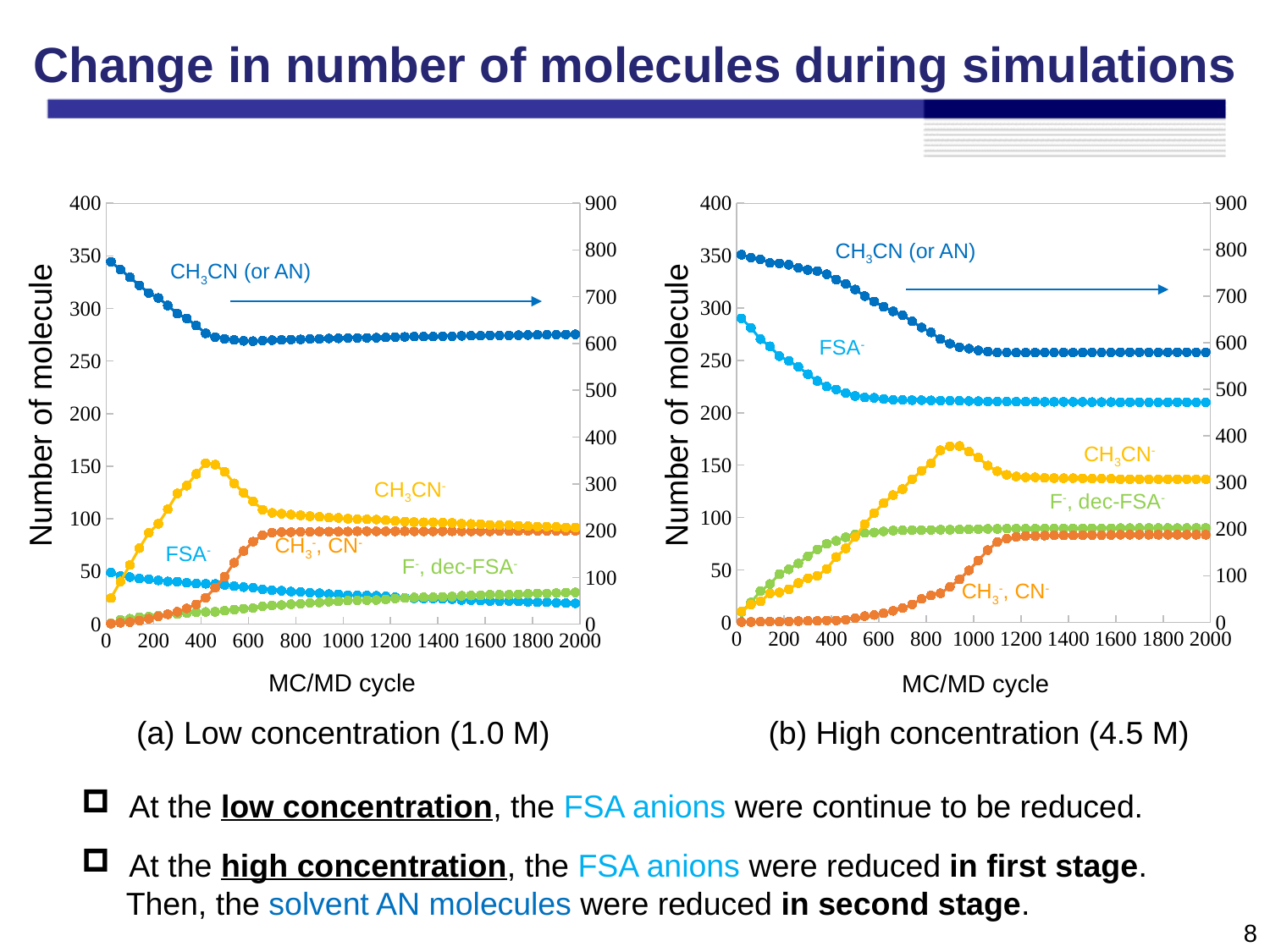
In panel (a) Low concentration (1.0 M), is the value of FSA- at cycle 0 greater or less than 100 on the left axis? less In panel (b) High concentration (4.5 M), is the value of FSA- at cycle 2000 greater or less than 250 on the left axis? less In panel (a) Low concentration (1.0 M), does the CH3-, CN- series rise or fall along the x axis? rise In panel (b) High concentration (4.5 M), at cycle 2000, which is larger: FSA- or CH3CN-? FSA- How many series are labelled in the chart for panel (b) High concentration (4.5 M)? 5 In panel (b) High concentration (4.5 M), does the CH3CN (or AN) series rise or fall along the x axis? fall What kind of chart is shown in panel (a) Low concentration (1.0 M)? line chart In panel (a) Low concentration (1.0 M), does the FSA- series rise or fall along the x axis? fall What is the maximum value shown on the right-hand axis of the chart in panel (b) High concentration (4.5 M)? 900 In panel (a) Low concentration (1.0 M), is the peak value of CH3CN- greater or less than 100 on the left axis? greater What is the x-axis label of the chart in panel (a) Low concentration (1.0 M)? MC/MD cycle